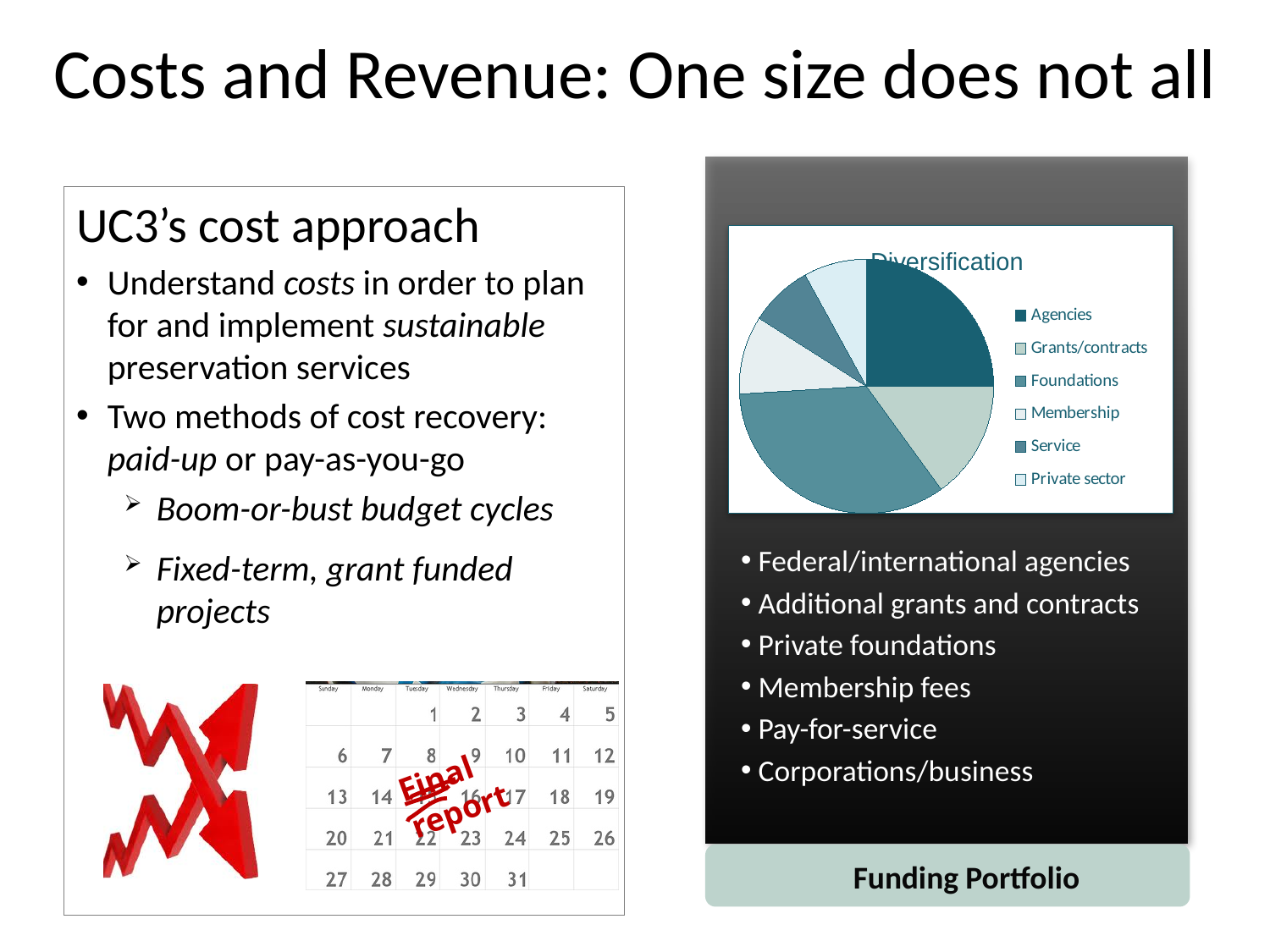
Which legend entry is listed first in the pie chart's legend? Agencies What is the title of the pie chart? Diversification What kind of chart is shown on the slide? pie chart Which slice is larger in the pie chart, Foundations or Agencies? Foundations Which slice is larger in the pie chart, Agencies or Membership? Agencies Which slice is larger in the pie chart, Foundations or Service? Foundations How many slices does the pie chart have? 6 Which category has the largest slice in the pie chart? Foundations How many entries does the pie chart's legend list? 6